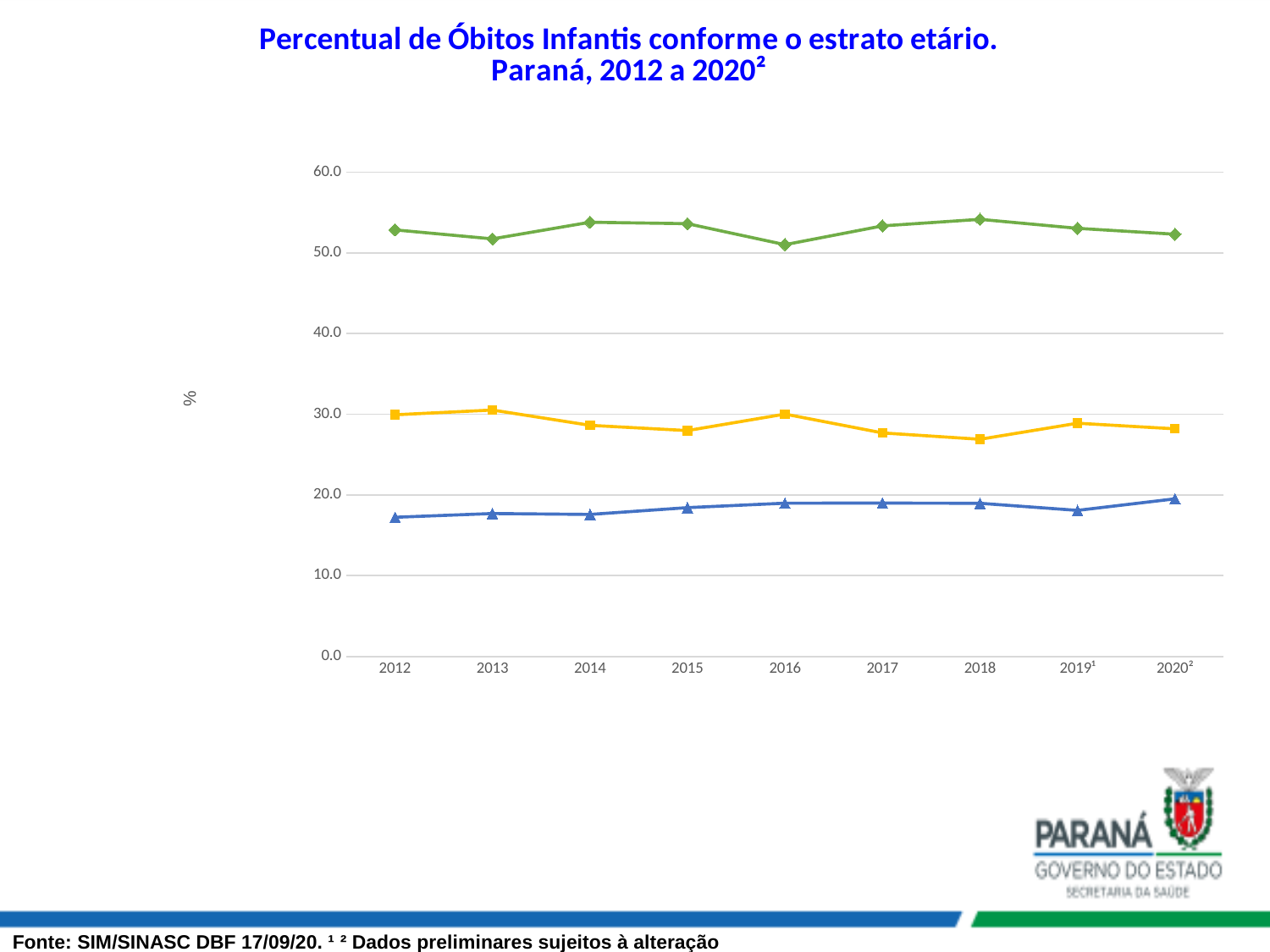
Is the value of the green line in 2018 greater or less than 50.0? greater In 2015, which line has the larger value, the green line or the yellow line? green line What is the title of the chart? Percentual de Óbitos Infantis conforme o estrato etário. Paraná, 2012 a 2020² What label is shown on the y axis of the chart? % Is the value of the green line in 2012 greater or less than 50.0? greater What kind of chart is shown on the slide? line chart Is the value of the yellow line in 2018 greater or less than 30.0? less For the blue line, which year has the larger value, 2012 or 2020²? 2020² Does the yellow line rise or fall from 2013 to 2015? fall How many lines are plotted on the chart? 3 How many years are shown along the x axis of the chart? 9